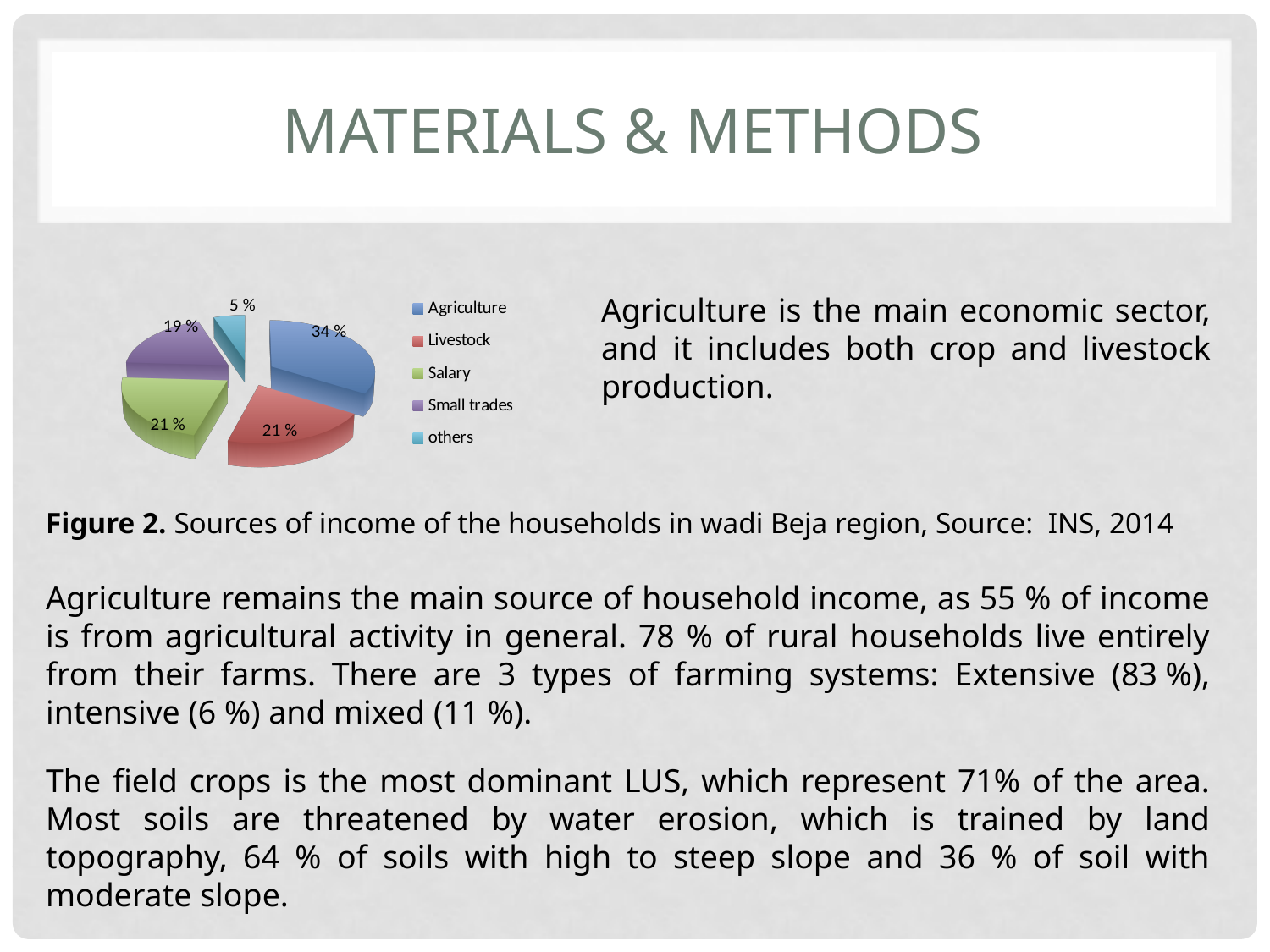
What percentage of household income comes from Agriculture in the pie chart? 34 % What value is shown for Small trades in the pie chart? 19 % What value is shown for the 'others' slice in the pie chart? 5 % What is the combined share of Livestock and Salary in the pie chart? 42 % How many slices does the pie chart have? 5 Which source of income has the smallest slice in the pie chart? others What is the difference between the Agriculture share and the 'others' share in the pie chart? 29 % How many entries does the legend of the pie chart list? 5 Which is larger in the pie chart, Agriculture or Small trades? Agriculture What kind of chart is shown on the slide? pie chart What colour is the Agriculture slice in the pie chart? blue Which source of income has the largest slice in the pie chart? Agriculture